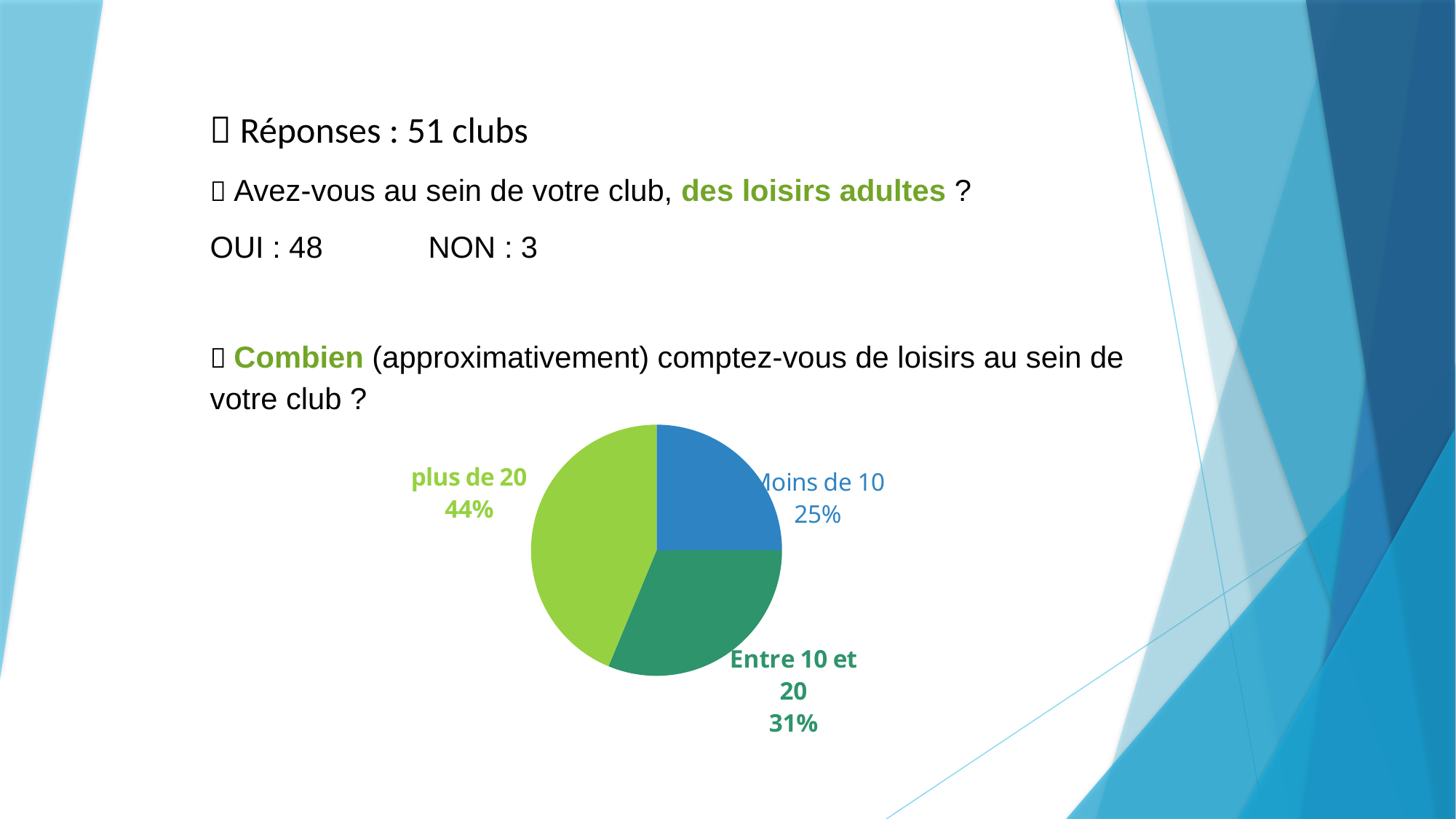
How many slices does the pie chart have? 3 Which slice is larger, 'plus de 20' or 'Entre 10 et 20'? plus de 20 What share of the pie does the 'Moins de 10' slice represent? 25% Which category has the smallest slice of the pie? Moins de 10 What is the difference in percentage points between the 'plus de 20' and 'Moins de 10' slices? 19 What colour is the 'Moins de 10' slice of the pie? blue What kind of chart is shown on the slide? pie chart What share of the pie does the 'plus de 20' slice represent? 44% Which category has the largest slice of the pie? plus de 20 What is the difference in percentage points between the 'Entre 10 et 20' and 'Moins de 10' slices? 6 Which slice is larger, 'Entre 10 et 20' or 'Moins de 10'? Entre 10 et 20 What share of the pie does the 'Entre 10 et 20' slice represent? 31%